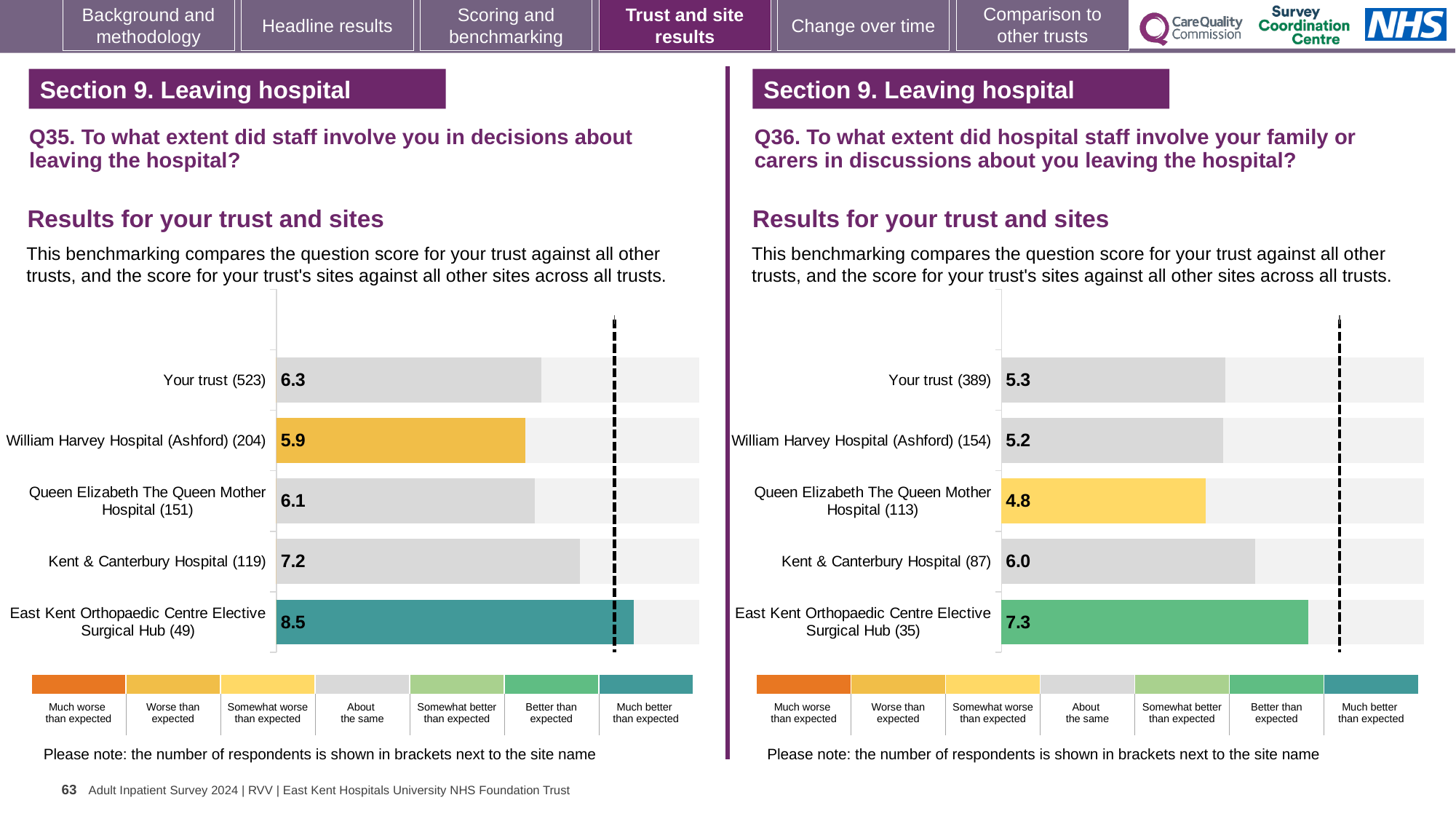
In the Q35 chart on the left, what benchmark category does the colour of the East Kent Orthopaedic Centre Elective Surgical Hub (49) bar indicate? Much better than expected In the Q36 chart on the right, what is the score for Your trust (389)? 5.3 What kind of chart is used for the Q36 results on the right? Bar chart How many bars are shown in the Q35 chart on the left? 5 In the Q36 chart on the right, what benchmark category does the colour of the Queen Elizabeth The Queen Mother Hospital (113) bar indicate? Somewhat worse than expected In the Q35 chart on the left, which has the higher score: Your trust (523) or Queen Elizabeth The Queen Mother Hospital (151)? Your trust (523) In the Q36 chart on the right, which has the higher score: East Kent Orthopaedic Centre Elective Surgical Hub (35) or Kent & Canterbury Hospital (87)? East Kent Orthopaedic Centre Elective Surgical Hub (35) In the Q35 chart on the left, what is the difference between the scores for East Kent Orthopaedic Centre Elective Surgical Hub (49) and William Harvey Hospital (Ashford) (204)? 2.6 In the Q36 chart on the right, which site has the lowest score? Queen Elizabeth The Queen Mother Hospital (113) In the Q36 chart on the right, what is the difference between the scores for Kent & Canterbury Hospital (87) and Your trust (389)? 0.7 In the Q35 chart on the left, which site has the highest score? East Kent Orthopaedic Centre Elective Surgical Hub (49) In the Q35 chart on the left, what is the score for Kent & Canterbury Hospital (119)? 7.2